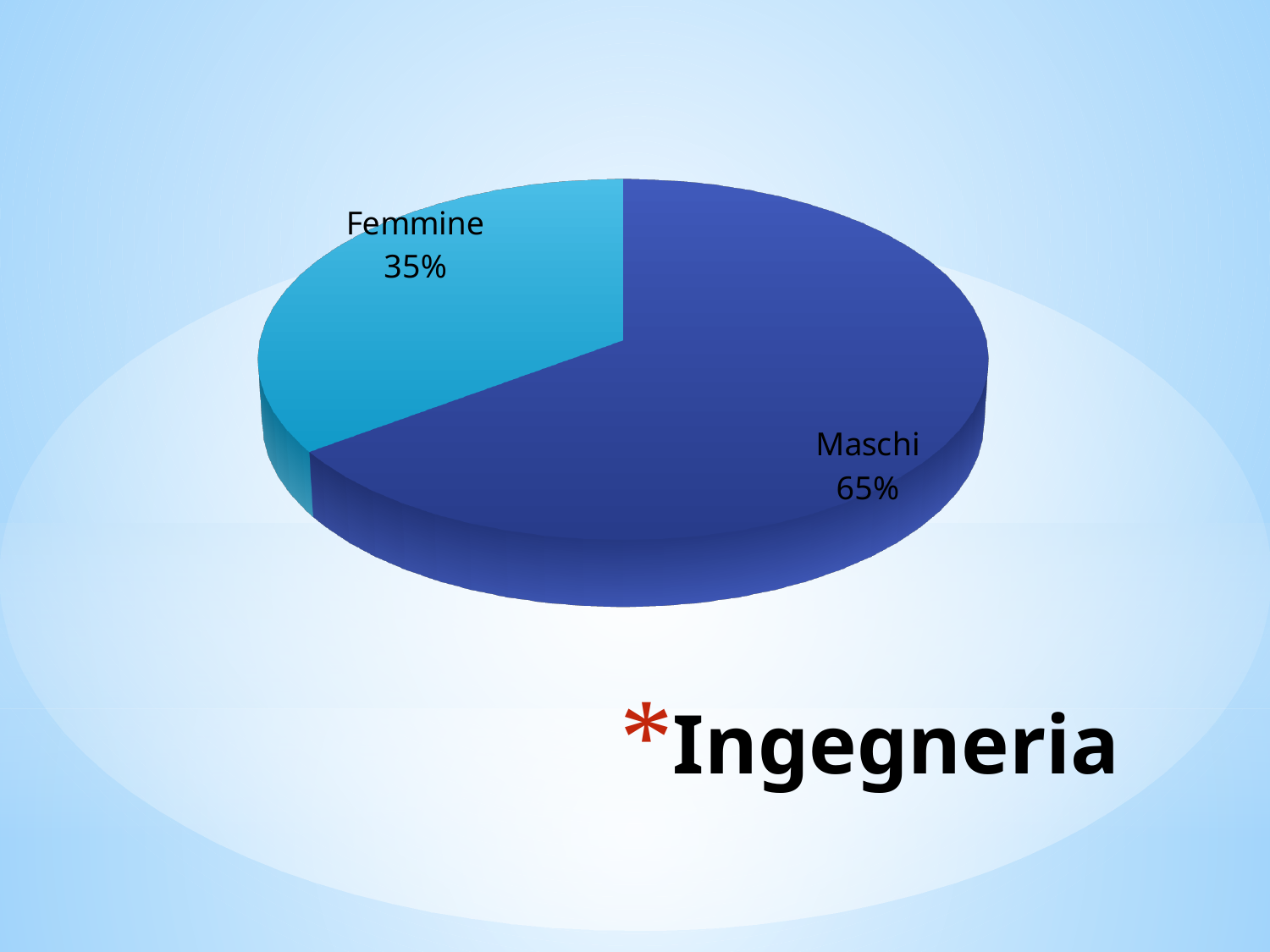
How many slices does the pie chart have? 2 Which is larger, the Maschi slice or the Femmine slice? Maschi What kind of chart is shown on the slide? pie chart What is the difference in percentage points between Maschi and Femmine? 30 What colour is the Femmine slice? light blue What is the text label shown below the chart on the slide? Ingegneria Which slice of the pie is the largest? Maschi What percentage of the pie is Maschi? 65% Which slice of the pie is the smallest? Femmine What share of the pie does the Femmine slice represent? 35% What percentage of the pie is Femmine? 35%